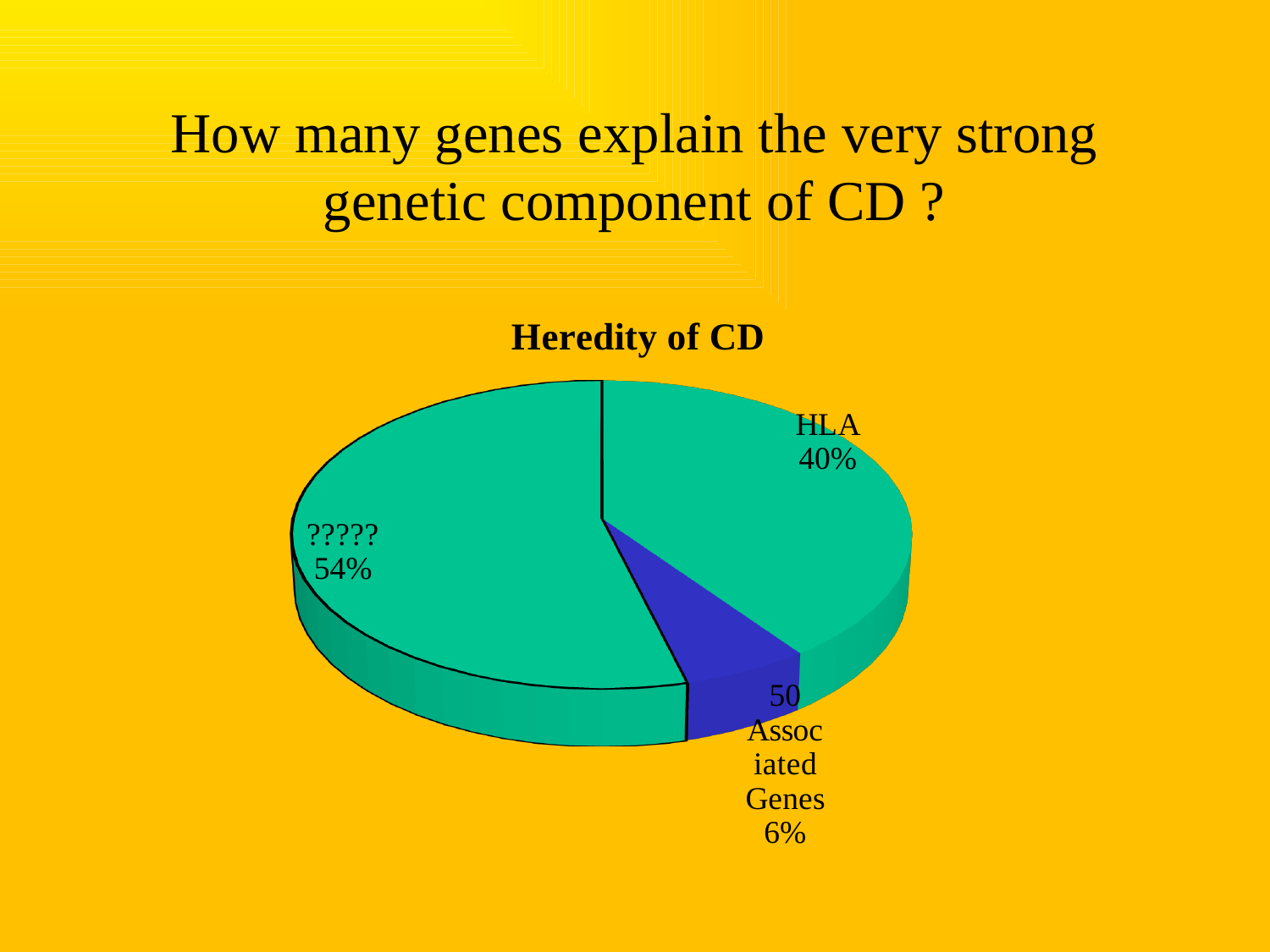
What colour is the 50 Associated Genes slice? blue What is the difference in percentage points between the ????? slice and the HLA slice? 14 What is the title of the chart? Heredity of CD What share of the pie do the 50 Associated Genes account for? 6% What kind of chart is shown on the slide? pie chart Which slice of the pie is the largest? ????? Which slice of the pie is the smallest? 50 Associated Genes What share of the pie does HLA account for? 40% Which is larger, the HLA slice or the 50 Associated Genes slice? HLA How many slices does the pie chart have? 3 What is the difference in percentage points between HLA and 50 Associated Genes? 34 What share of the pie does the ????? slice account for? 54%